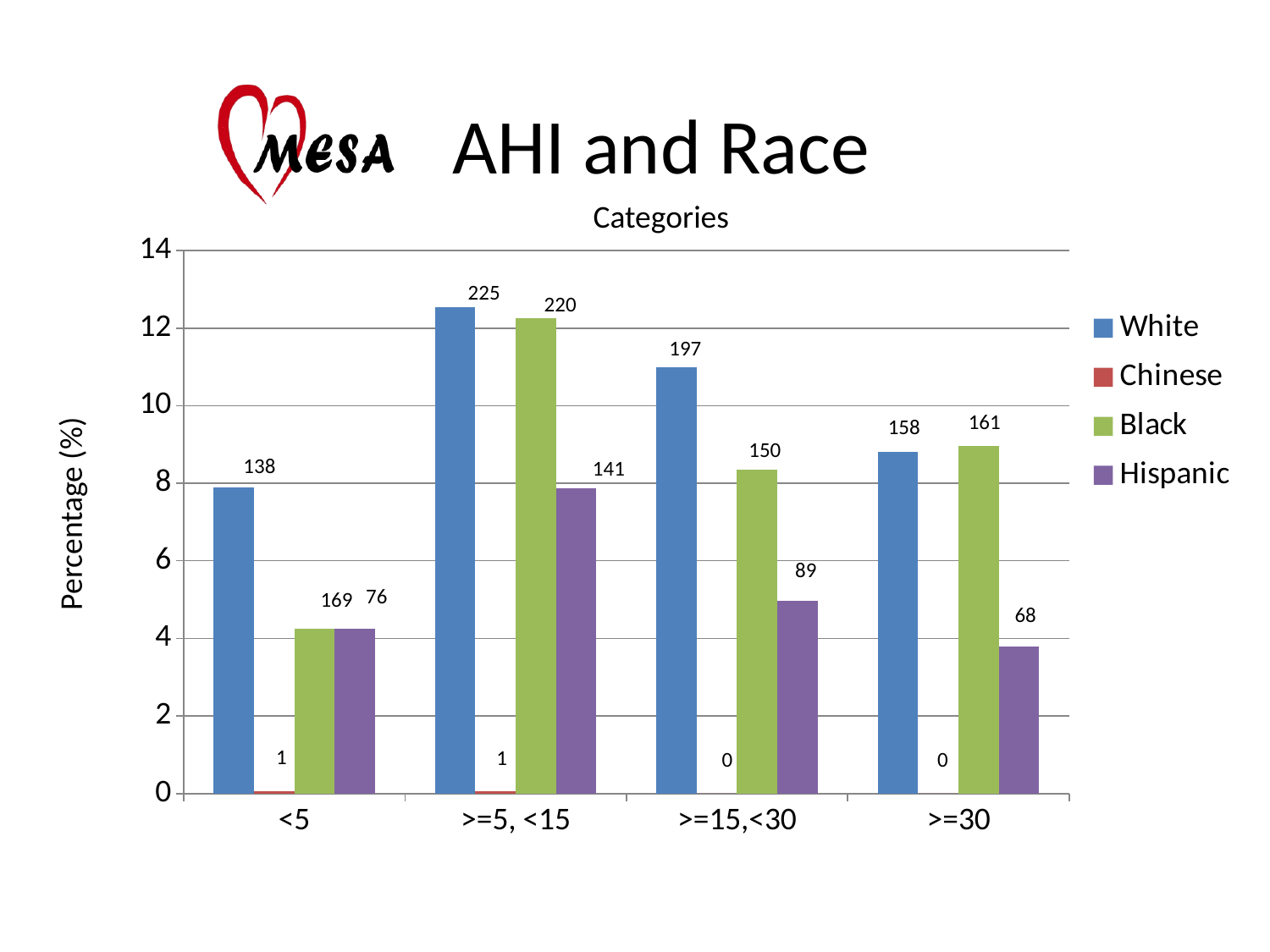
What data label is printed on the Chinese bar for the >=15,<30 category? 0 What data label is printed on the White bar for the <5 category? 138 What data label is printed on the Hispanic bar for the >=30 category? 68 What is the title of the vertical axis? Percentage (%) In the >=15,<30 category, which series has the tallest bar? White Is the White bar for the >=5, <15 category greater or less than 12 on the percentage axis? greater What data label is printed on the Black bar for the >=5, <15 category? 220 What kind of chart is shown on the slide? bar chart How many AHI categories are shown on the x axis? 4 Which series has the lowest bar in every category? Chinese How many series does the legend list? 4 What is the difference between the data labels on the White and Black bars in the >=5, <15 category? 5